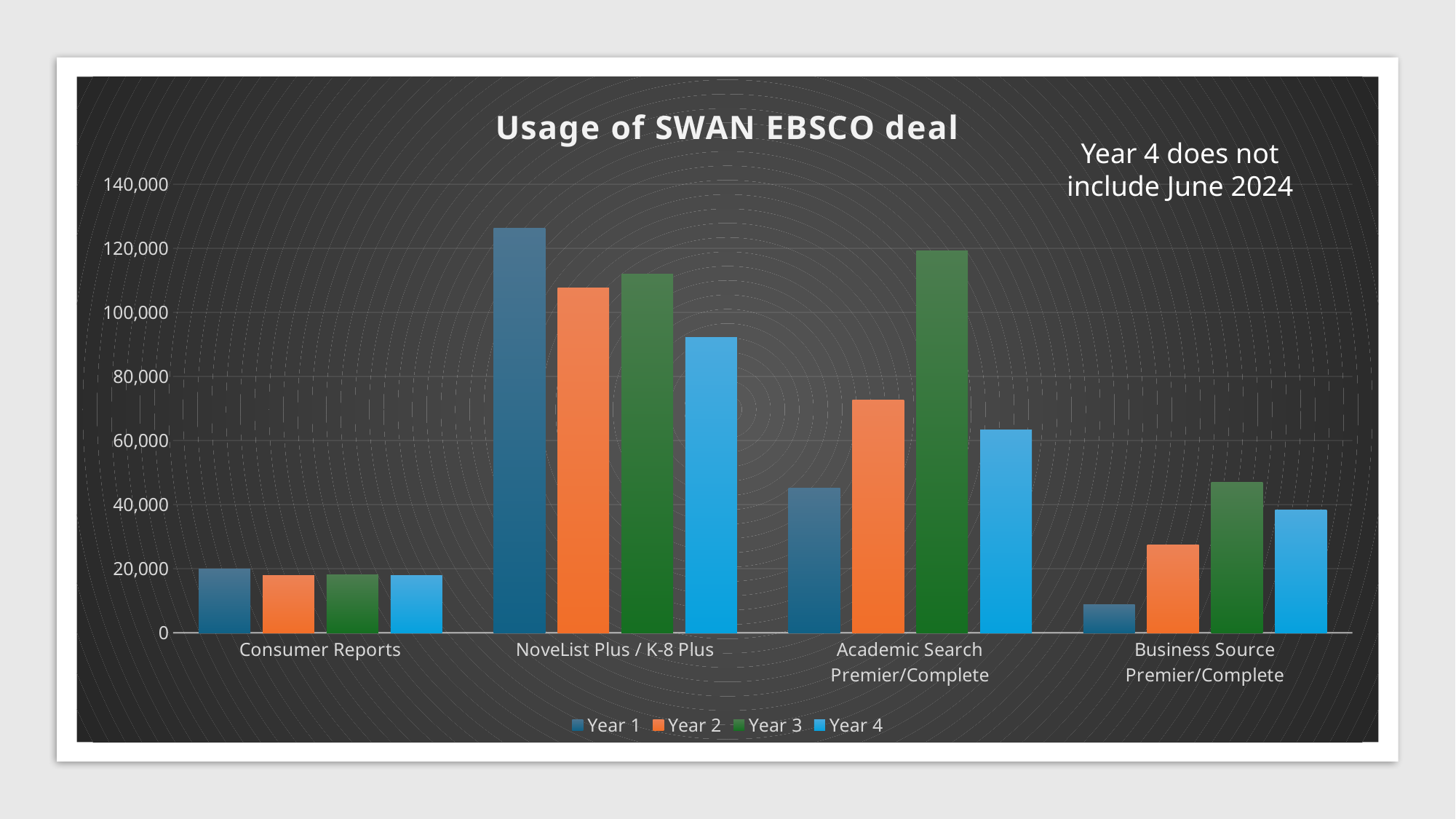
Is the Year 4 value for Academic Search Premier/Complete greater or less than 80,000? less Is the Year 1 value for NoveList Plus / K-8 Plus greater or less than 120,000? greater How many series does the legend list? 4 How many categories are shown on the x axis? 4 What is the title of the chart? Usage of SWAN EBSCO deal For Business Source Premier/Complete, which is larger: Year 1 or Year 2? Year 2 For Academic Search Premier/Complete, which is larger: Year 2 or Year 3? Year 3 Which category has the highest Year 1 value? NoveList Plus / K-8 Plus Which category has the lowest Year 1 value? Business Source Premier/Complete What note is shown in the top right of the chart about Year 4? Year 4 does not include June 2024 What kind of chart is shown on the slide? Bar chart Which year has the highest value for Academic Search Premier/Complete? Year 3